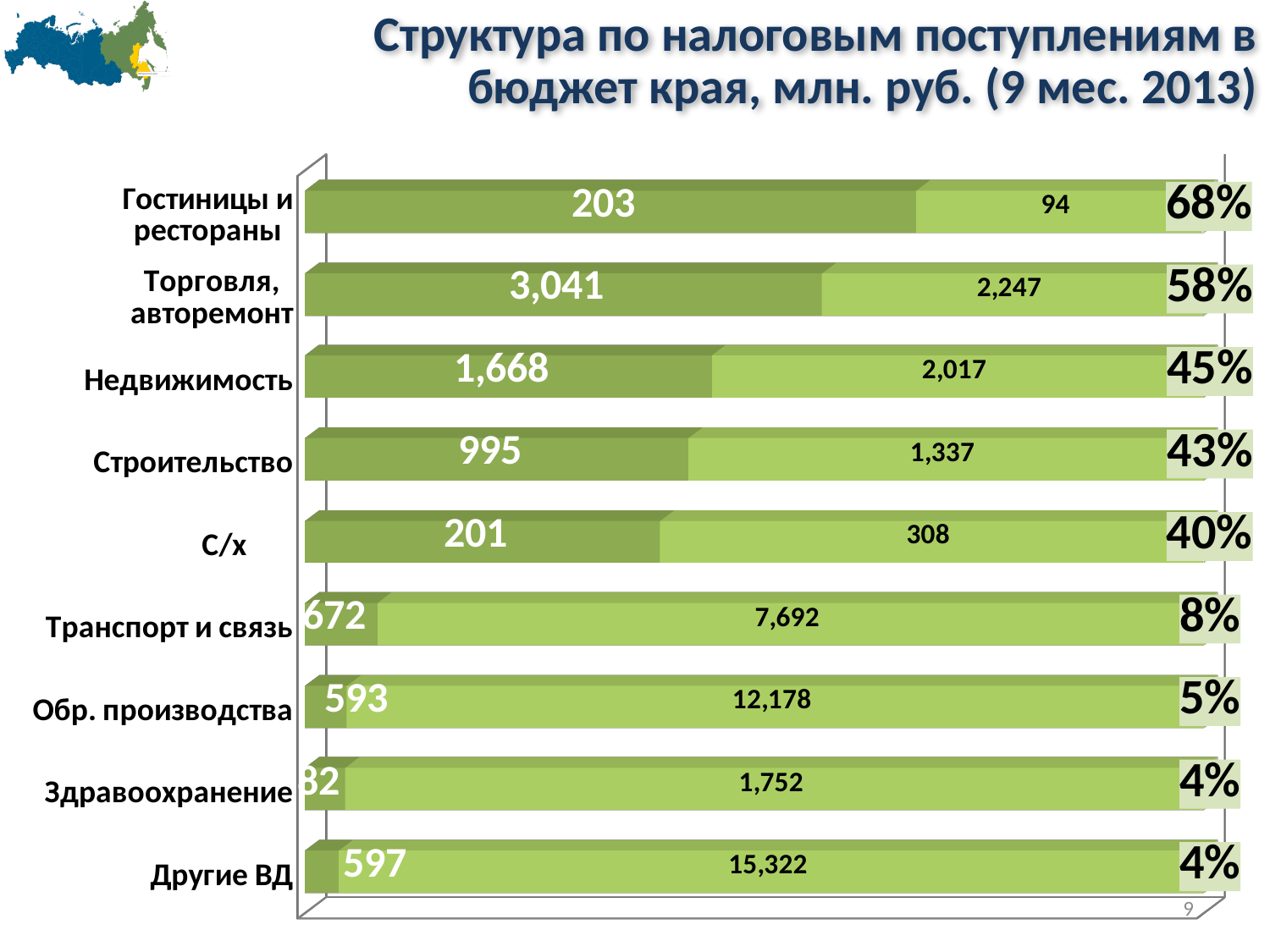
Do the percentages shown at the right of the bars increase or decrease from the top category to the bottom category? decrease What kind of chart is shown on the slide? bar chart What is the dark green value for Торговля, авторемонт? 3,041 How many categories are shown in the chart? 9 Which has the larger light green value: Транспорт и связь or Обр. производства? Обр. производства What is the dark green value for С/х? 201 What is the light green value for Другие ВД? 15,322 What is the total of the two values shown for Строительство? 2,332 What is the light green value for Обр. производства? 12,178 Which category has the highest percentage shown at the right of the bars? Гостиницы и рестораны What percentage is shown for Гостиницы и рестораны? 68% What is the difference between the light green value (2,017) and the dark green value (1,668) for Недвижимость? 349